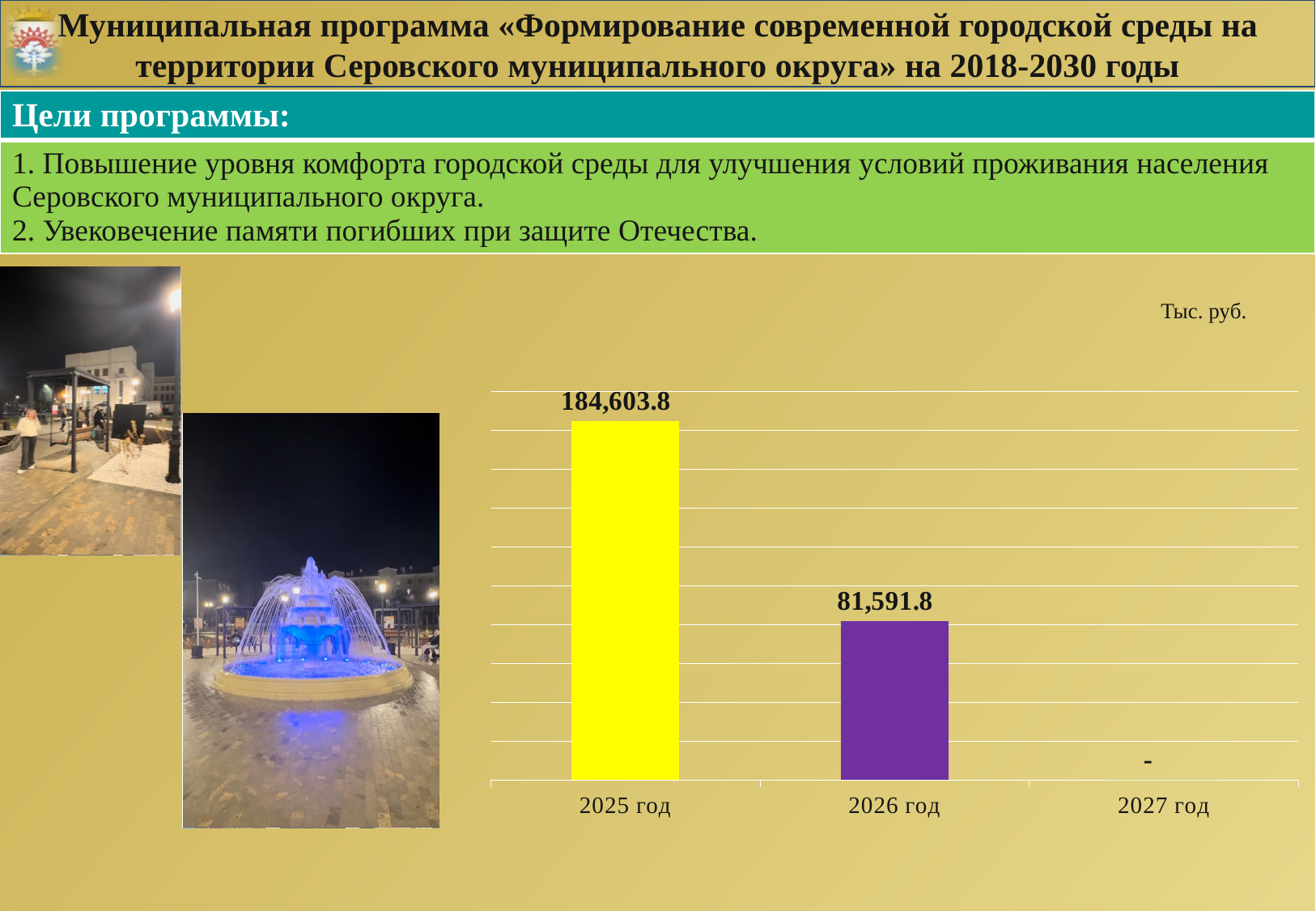
What is shown as the value for 2027 год? - What colour is the bar for 2026 год? Purple Which is larger, the value for 2025 год or the value for 2026 год? 2025 год What kind of chart is shown on the slide? Bar chart What is the difference between the values for 2025 год and 2026 год? 103,012.0 What is the value shown for 2025 год? 184,603.8 How many year categories are shown on the x axis of the chart? 3 Do the values rise or fall from 2025 год to 2026 год? Fall What unit label is shown above the chart? Тыс. руб. What is the value shown for 2026 год? 81,591.8 Among the years with a plotted bar, which has the lowest value? 2026 год Which year has the highest value in the chart? 2025 год